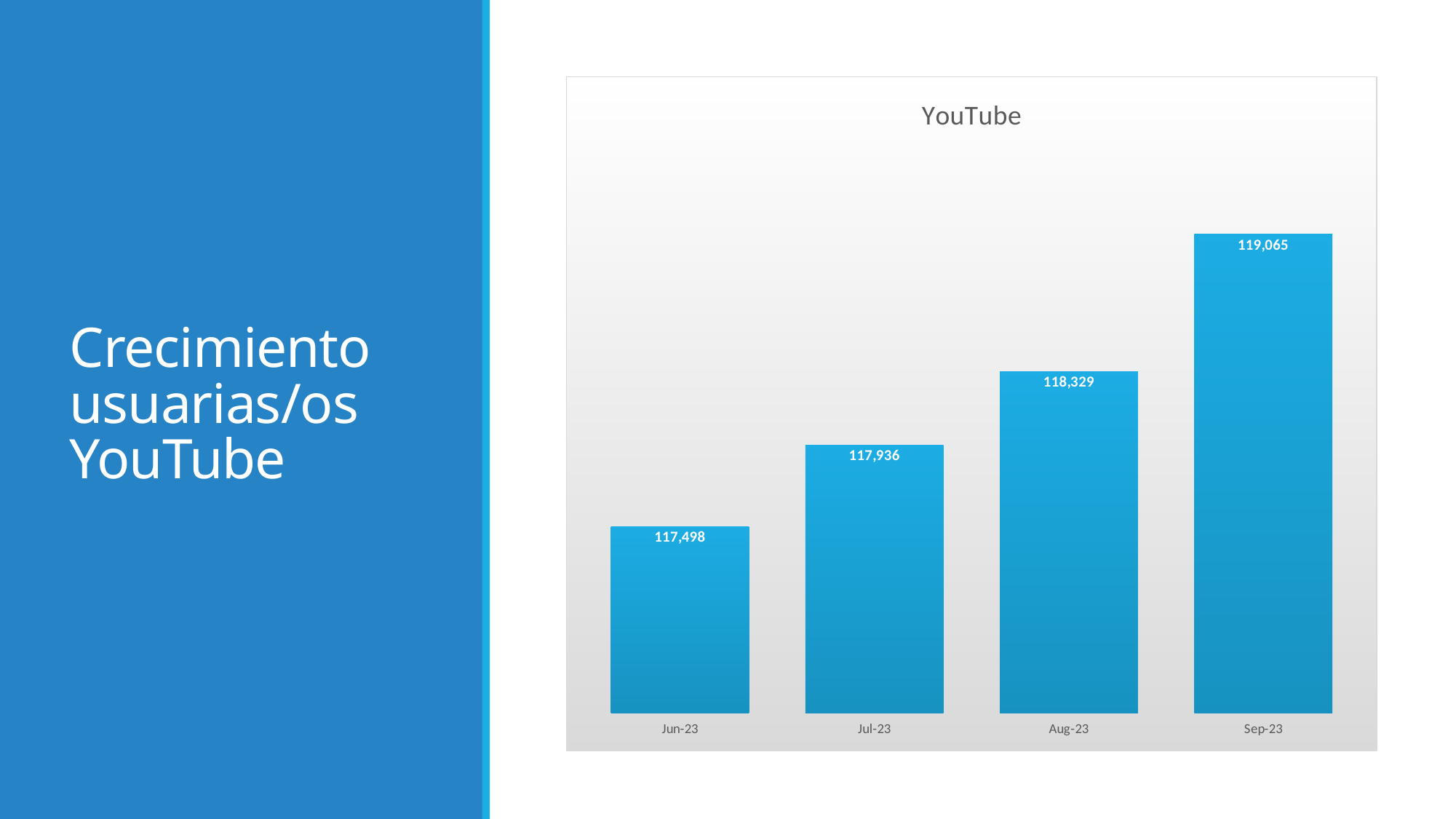
Which month has the highest value? Sep-23 What is the value for Aug-23? 118,329 What is the difference between the values for Sep-23 and Jun-23? 1,567 What is the value for Sep-23? 119,065 What kind of chart is shown? Bar chart What is the value for Jul-23? 117,936 What is the value for Jun-23? 117,498 How many months are shown on the chart? 4 Do the values rise or fall from Jun-23 to Sep-23? Rise What is the difference between the values for Aug-23 and Jul-23? 393 Which month has the lowest value? Jun-23 Which is larger, the value for Jul-23 or the value for Aug-23? Aug-23